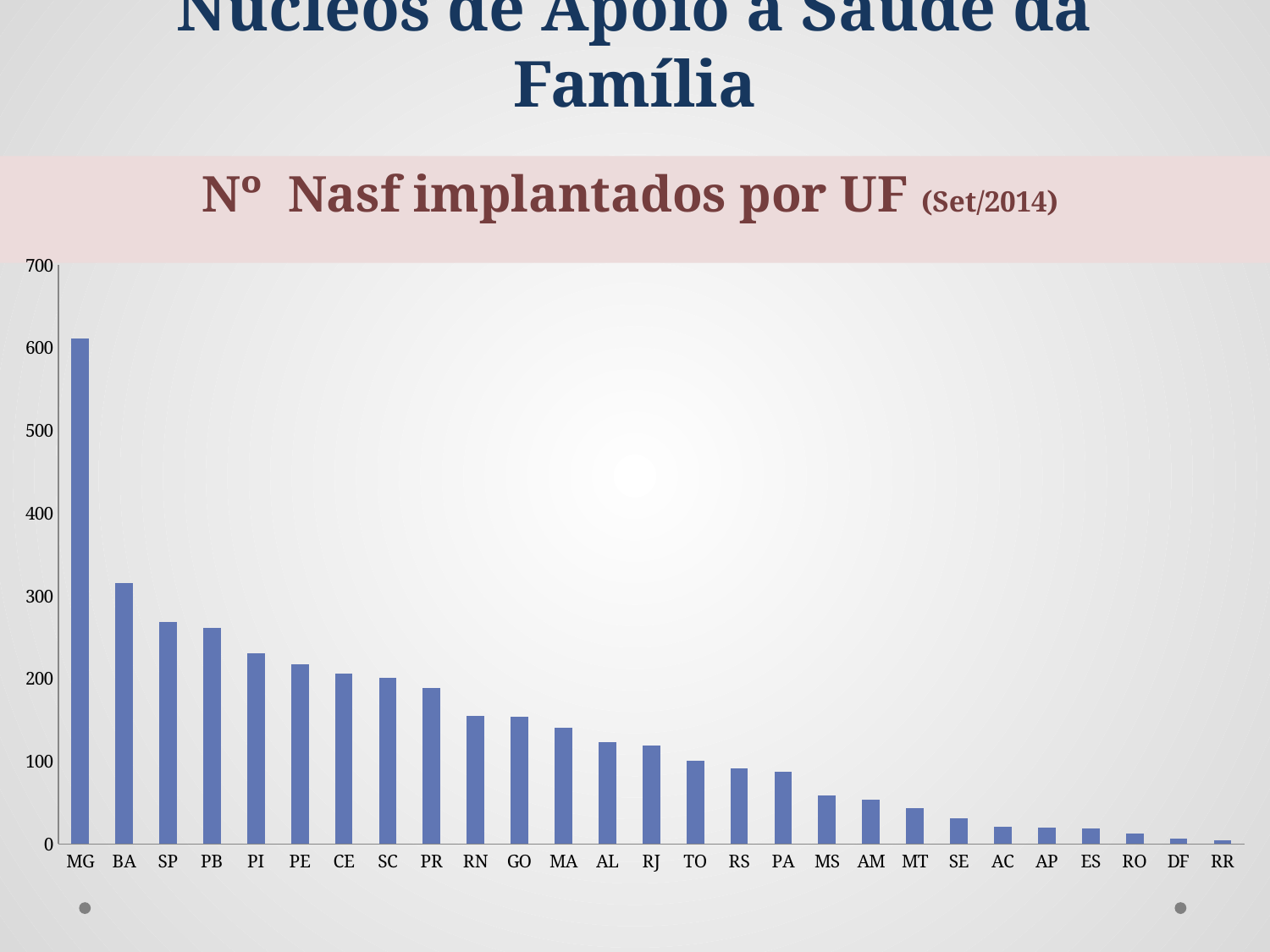
Is the value for RS greater or less than 100? less Is the value for PR greater or less than 200? less Which has a larger value, BA or SP? BA Which has a larger value, MS or AM? MS Is the value for SP greater or less than 300? less What kind of chart is shown on the slide? bar chart Which UF has the highest number of Nasf implantados? MG How many UFs are shown on the x axis? 27 Do the values rise or fall from left to right along the x axis? fall